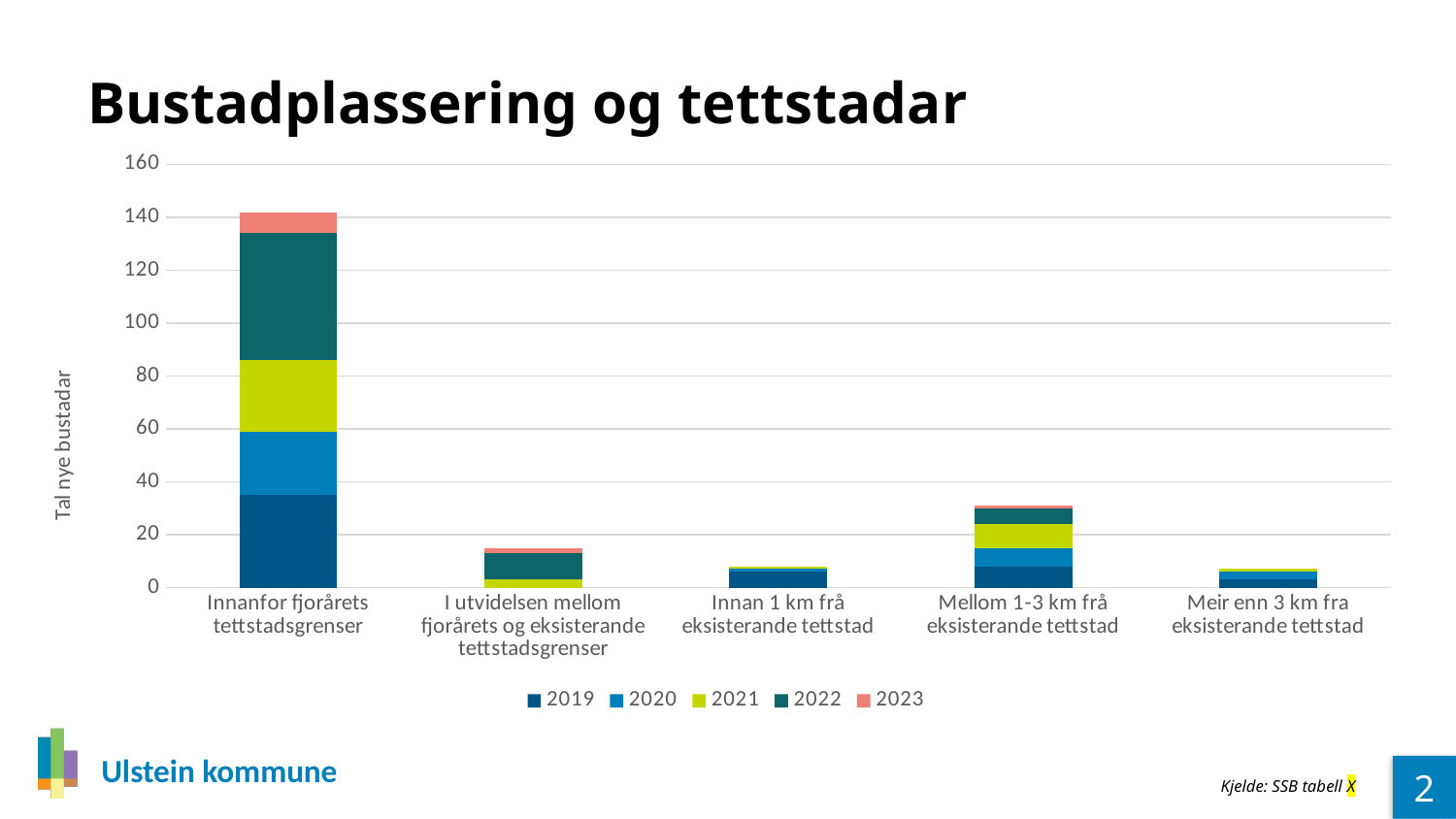
How many categories are shown along the x axis of the chart? 5 Is the total stacked value for 'Mellom 1-3 km frå eksisterande tettstad' greater or less than 20? greater What is the title of the chart on the slide? Bustadplassering og tettstadar Is the total stacked value for 'Innanfor fjorårets tettstadsgrenser' greater or less than 120? greater Which has the larger total stacked bar: 'Mellom 1-3 km frå eksisterande tettstad' or 'I utvidelsen mellom fjorårets og eksisterande tettstadsgrenser'? Mellom 1-3 km frå eksisterande tettstad How many series does the legend list? 5 What kind of chart is shown on the slide? Stacked bar chart Is the total stacked value for 'Mellom 1-3 km frå eksisterande tettstad' greater or less than 40? less What is the label on the y axis of the chart? Tal nye bustadar Which category has the highest total stacked bar? Innanfor fjorårets tettstadsgrenser